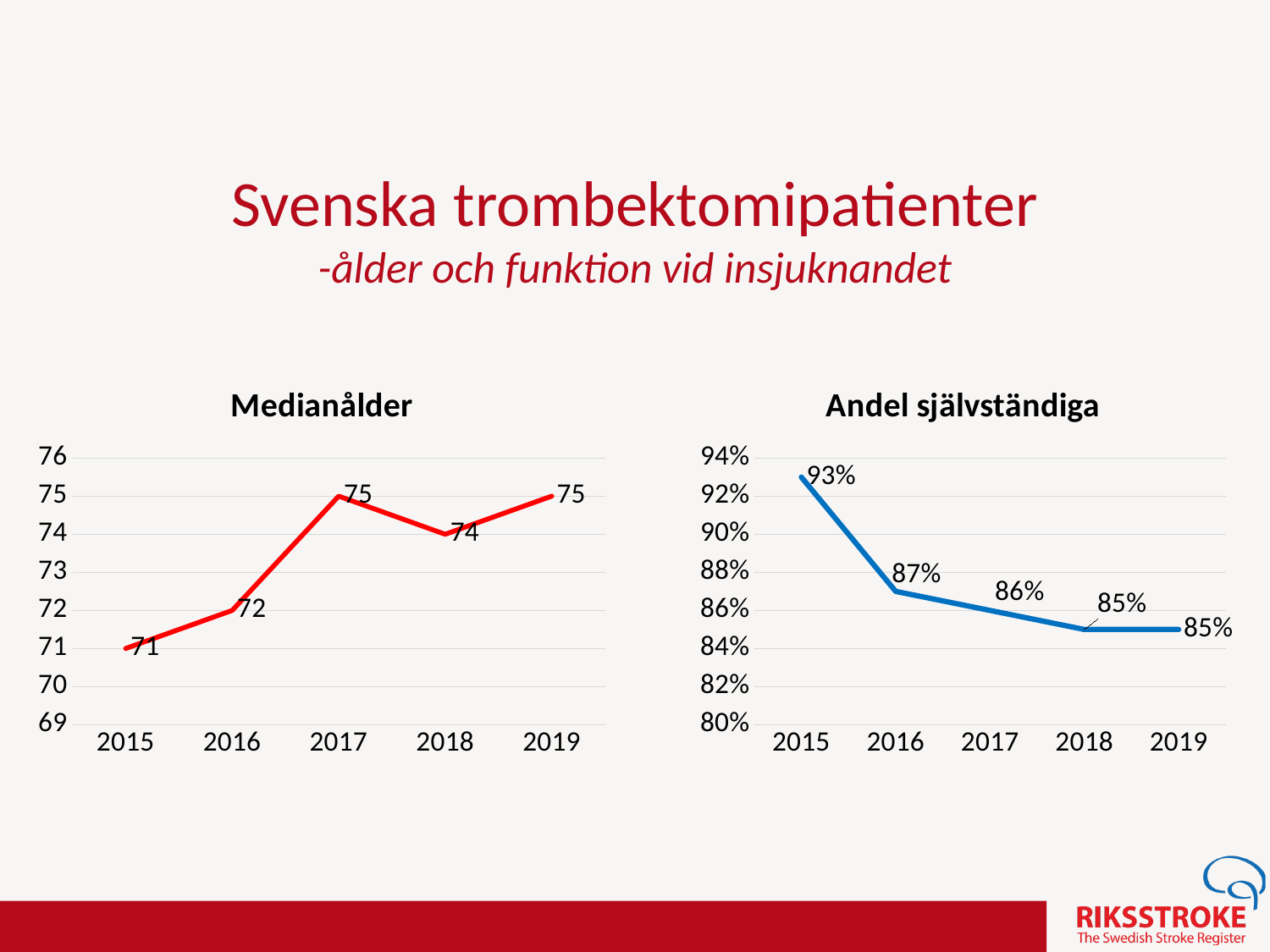
In the Medianålder chart, what is the value for 2015? 71 What kind of chart is the Medianålder chart? line chart In the Medianålder chart, how many years are plotted? 5 In the Medianålder chart, what is the difference between the values for 2017 and 2016? 3 In the Medianålder chart, is the value for 2016 greater or less than 2017? less In the Andel självständiga chart, do the values generally rise or fall from 2015 to 2019? fall In the Andel självständiga chart, what is the value for 2017? 86% In the Andel självständiga chart, what is the value for 2015? 93% In the Andel självständiga chart, what is the difference between the values for 2015 and 2016? 6% In the Medianålder chart, which year has the lowest value? 2015 In the Medianålder chart, what is the value for 2018? 74 In the Andel självständiga chart, which year has the highest value? 2015